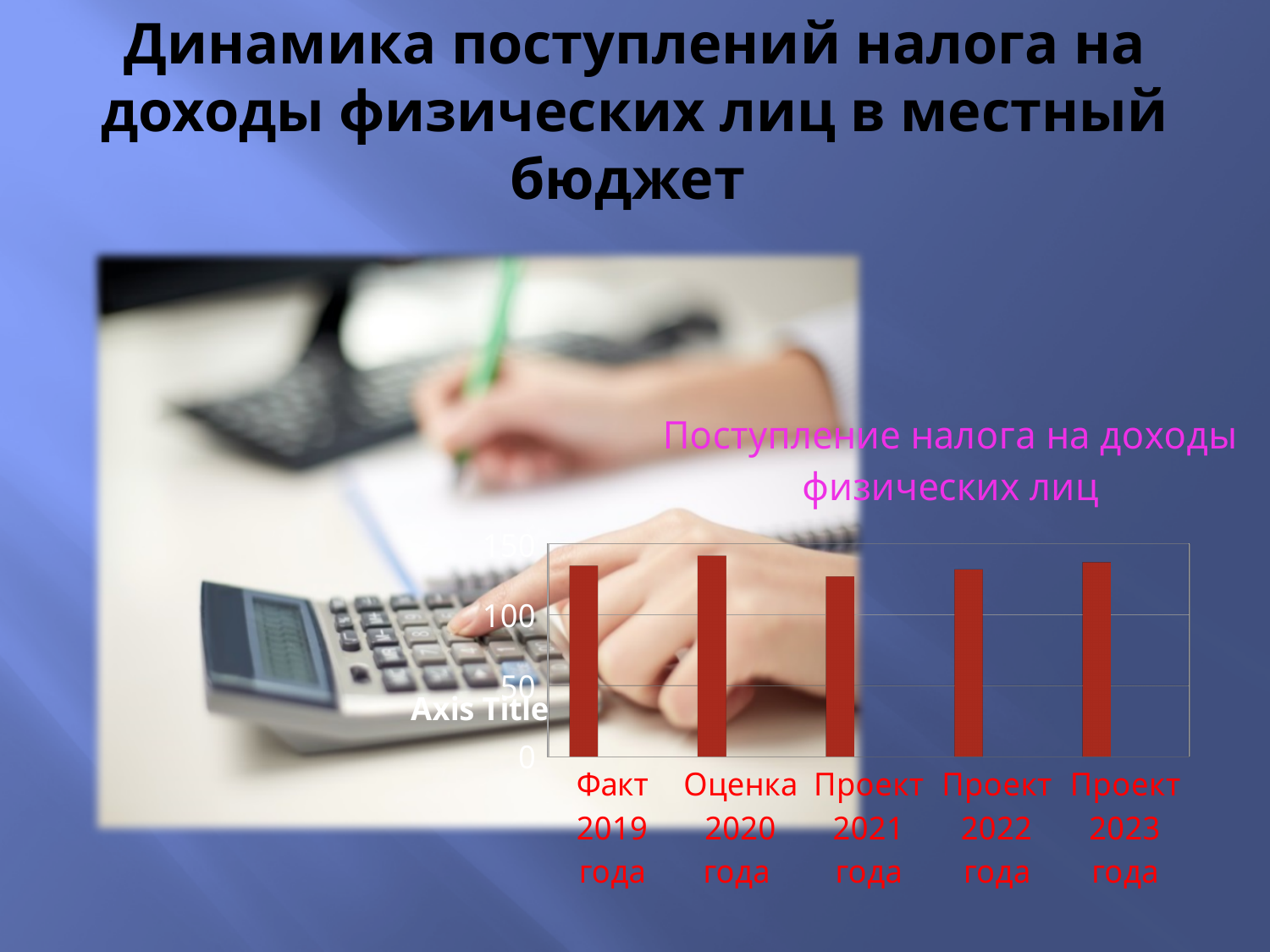
What is the title of the chart? Поступление налога на доходы физических лиц Is the value for Проект 2022 года greater or less than 150? less Which is larger, the value for Оценка 2020 года or the value for Проект 2021 года? Оценка 2020 года How many categories are shown on the x axis of the chart? 5 Which category has the lowest bar in the chart? Проект 2021 года Is the value for Проект 2023 года greater or less than 100? greater Is the value for Факт 2019 года greater or less than 100? greater What kind of chart is shown on the slide? bar chart What is the label shown on the vertical axis of the chart? Axis Title Which category has the highest bar in the chart? Оценка 2020 года